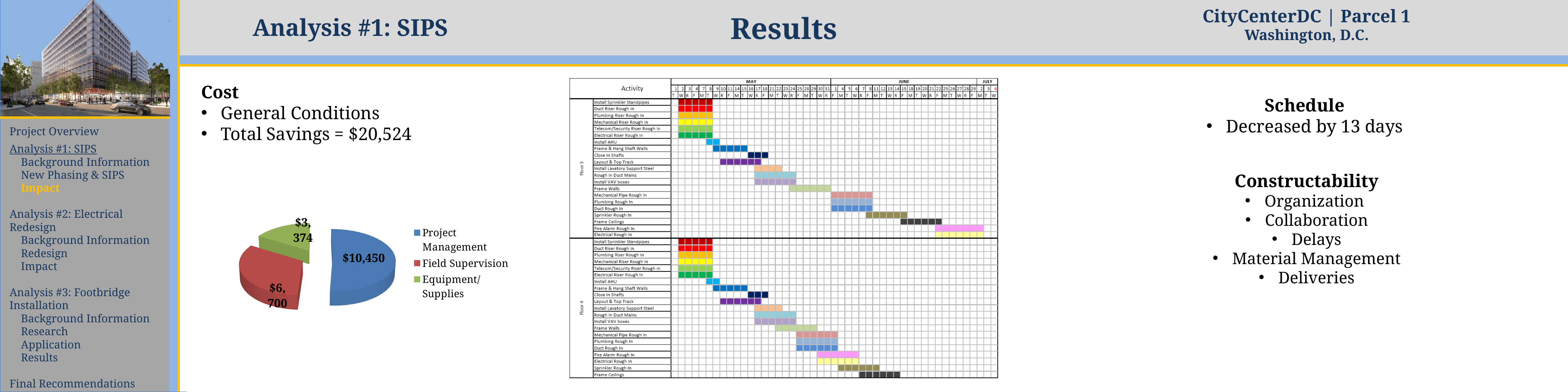
How many slices does the pie chart have? 3 On the pie chart, what is the value for Project Management? $10,450 On the pie chart, what colour is the Field Supervision slice? Red What type of chart is used to show the cost savings breakdown on the left of the slide? Pie chart On the pie chart, which category has the smallest slice? Equipment/Supplies On the pie chart, what is the value for Equipment/Supplies? $3,374 On the pie chart, what is the difference between the Field Supervision and Equipment/Supplies values? $3,326 On the pie chart, what is the value for Field Supervision? $6,700 On the pie chart, which is larger: Field Supervision or Equipment/Supplies? Field Supervision On the pie chart, what is the difference between the Project Management and Field Supervision values? $3,750 What is the total of all slices on the pie chart? $20,524 On the pie chart, which category has the largest slice? Project Management